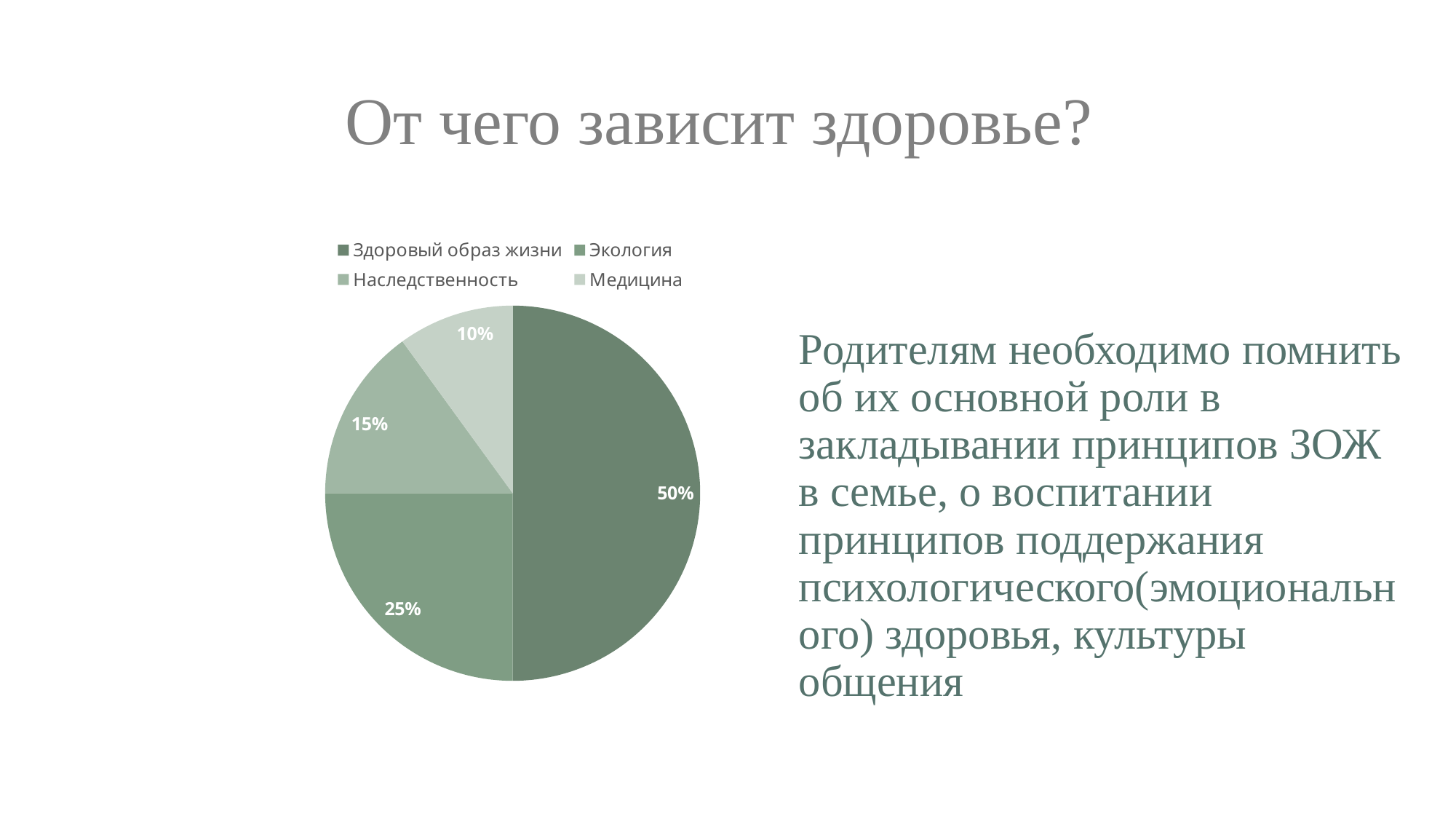
What share of the pie does "Здоровый образ жизни" have? 50% Which is larger, the share of "Наследственность" or the share of "Медицина"? Наследственность What kind of chart is shown on the slide? pie chart What is the difference between the shares of "Здоровый образ жизни" and "Экология"? 25% What is the title of the slide containing the pie chart? От чего зависит здоровье? What share of the pie does "Медицина" have? 10% What share of the pie does "Наследственность" have? 15% How many categories does the pie chart have? 4 Which category has the largest slice of the pie? Здоровый образ жизни Which category has the smallest slice of the pie? Медицина What share of the pie does "Экология" have? 25% How many entries does the legend list? 4